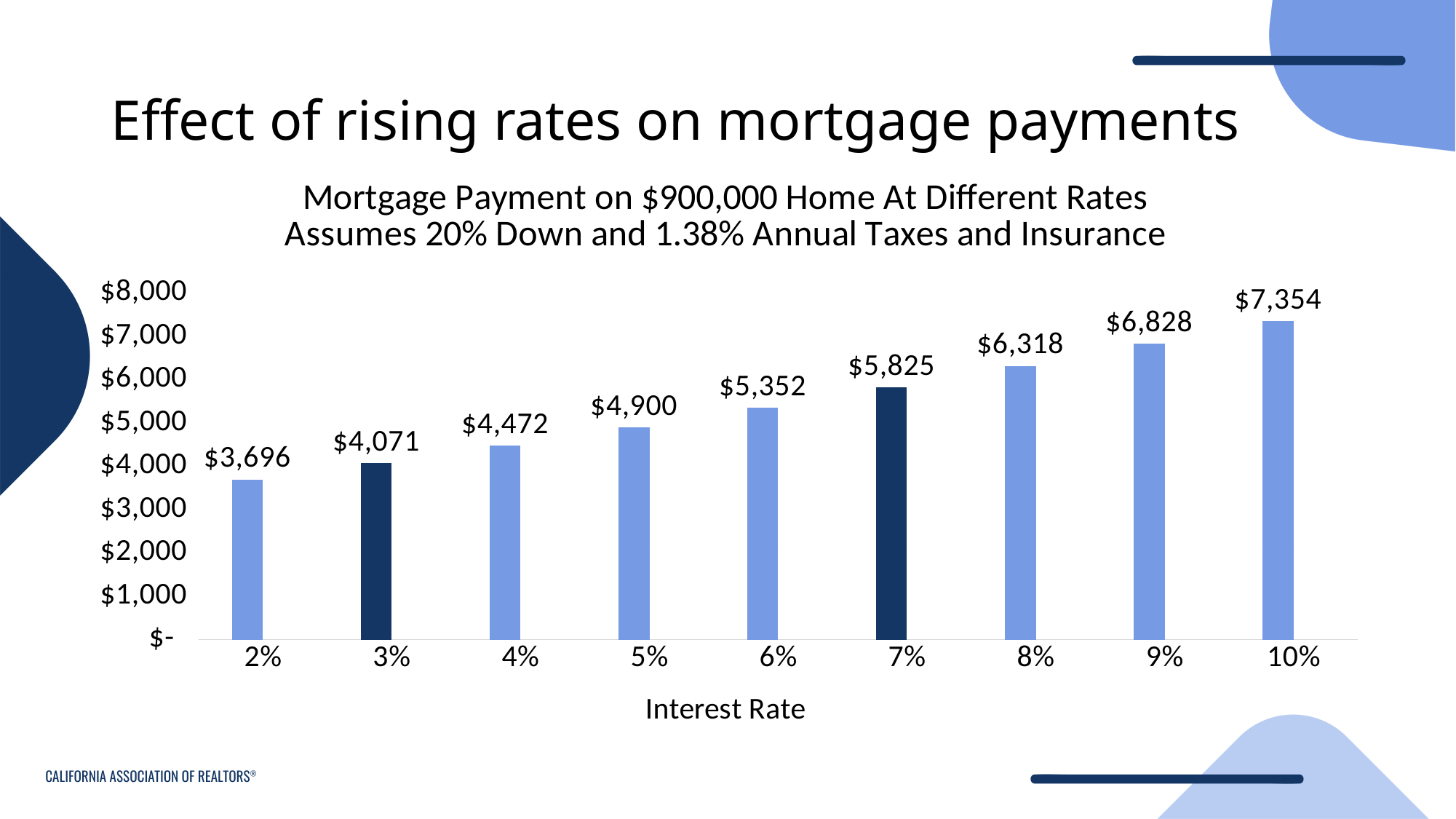
How many interest rates are shown on the x axis? 9 What is the difference between the mortgage payment at 7% and at 3%? $1,754 Which two bars are shaded in a darker blue than the others? 3% and 7% What kind of chart is shown on the slide? bar chart What is the mortgage payment at a 5% interest rate? $4,900 Which interest rate has the lowest mortgage payment? 2% Which interest rate has the highest mortgage payment? 10% What is the mortgage payment at a 9% interest rate? $6,828 Do mortgage payments rise or fall as the interest rate increases along the x axis? rise Which is larger, the mortgage payment at 4% or at 6%? 6% What is the label of the x axis? Interest Rate Is the mortgage payment at 8% greater or less than $6,000? greater